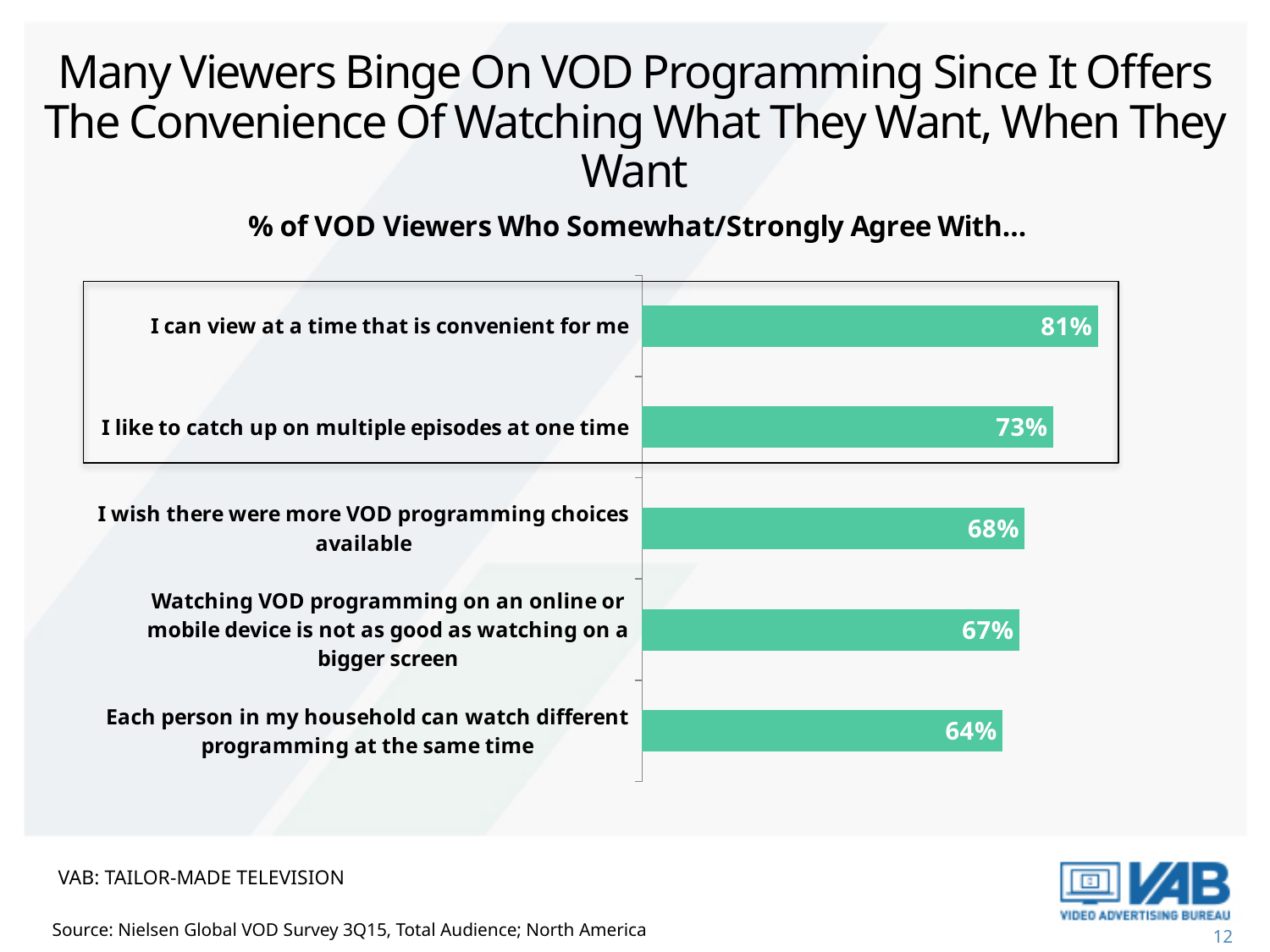
Which statement has the lowest share of VOD viewers agreeing with it? Each person in my household can watch different programming at the same time What percentage of VOD viewers agree that each person in their household can watch different programming at the same time? 64% What percentage of VOD viewers wish there were more VOD programming choices available? 68% Which has a higher agreement rate: "I wish there were more VOD programming choices available" or "Watching VOD programming on an online or mobile device is not as good as watching on a bigger screen"? I wish there were more VOD programming choices available Which statement has the highest share of VOD viewers agreeing with it? I can view at a time that is convenient for me What percentage of VOD viewers agree with "I can view at a time that is convenient for me"? 81% What is the difference in percentage points between the highest and lowest values in the chart? 17 percentage points What is the title of the chart? % of VOD Viewers Who Somewhat/Strongly Agree With... What type of chart is shown on the slide? Bar chart What is the difference in percentage points between "I can view at a time that is convenient for me" and "I like to catch up on multiple episodes at one time"? 8 percentage points How many statements are shown in the chart? 5 What percentage of VOD viewers agree with "I like to catch up on multiple episodes at one time"? 73%